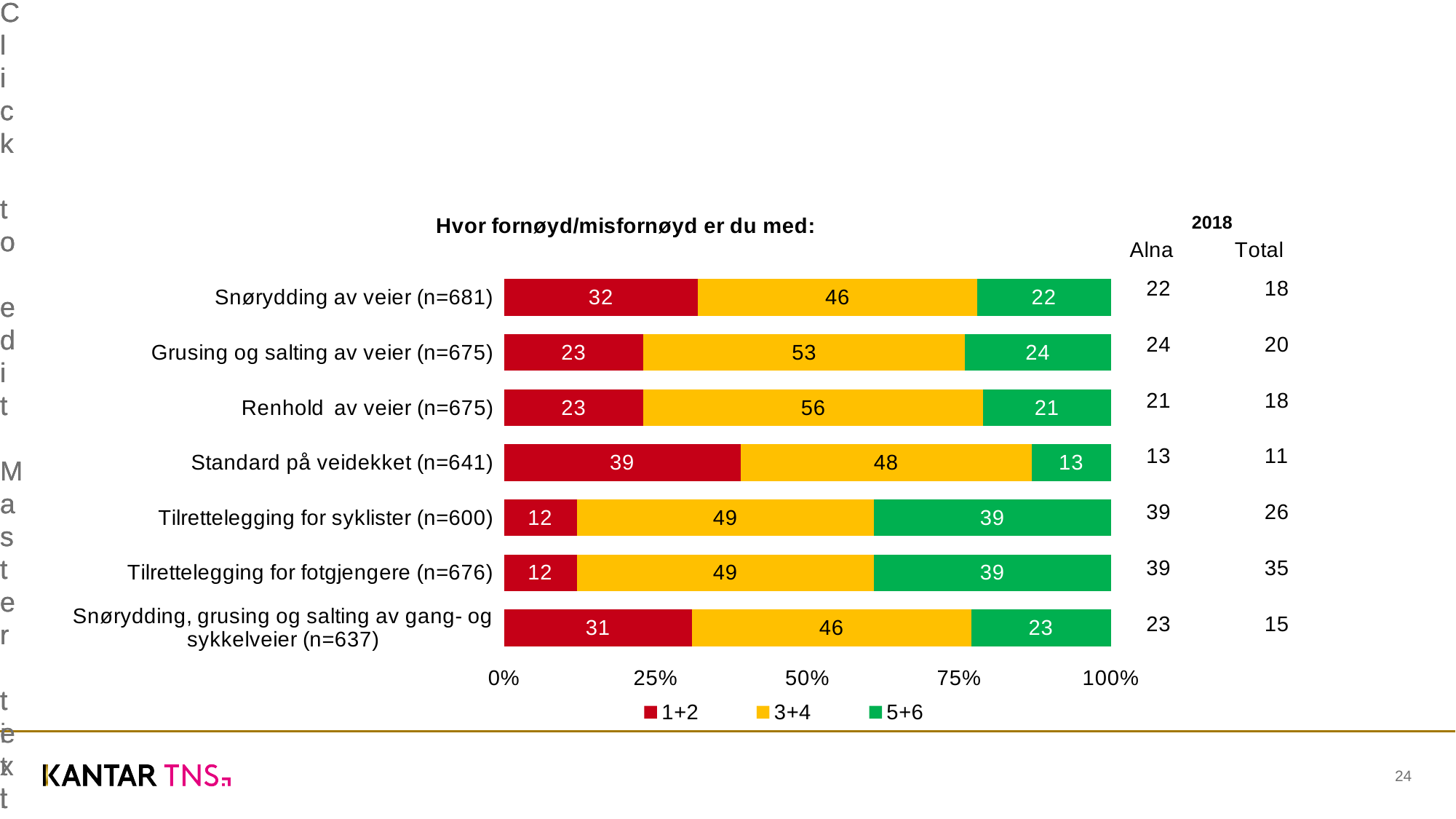
Which category has the lowest value in the 5+6 series? Standard på veidekket (n=641) How many series does the legend list? 3 What is the value of the 3+4 series for Renhold av veier (n=675)? 56 What is the value of the 5+6 series for Tilrettelegging for syklister (n=600)? 39 How many categories are plotted in the chart? 7 What is the title of the chart? Hvor fornøyd/misfornøyd er du med: Which category has the highest value in the 1+2 series? Standard på veidekket (n=641) What is the total of the stacked bar for Snørydding, grusing og salting av gang- og sykkelveier (n=637)? 100 What is the value of the 1+2 series for Standard på veidekket (n=641)? 39 What kind of chart is shown on the slide? stacked bar chart What is the difference between the 3+4 value for Renhold av veier (n=675) and the 3+4 value for Snørydding av veier (n=681)? 10 Which is larger: the 1+2 value for Snørydding av veier (n=681) or the 1+2 value for Grusing og salting av veier (n=675)? Snørydding av veier (n=681)